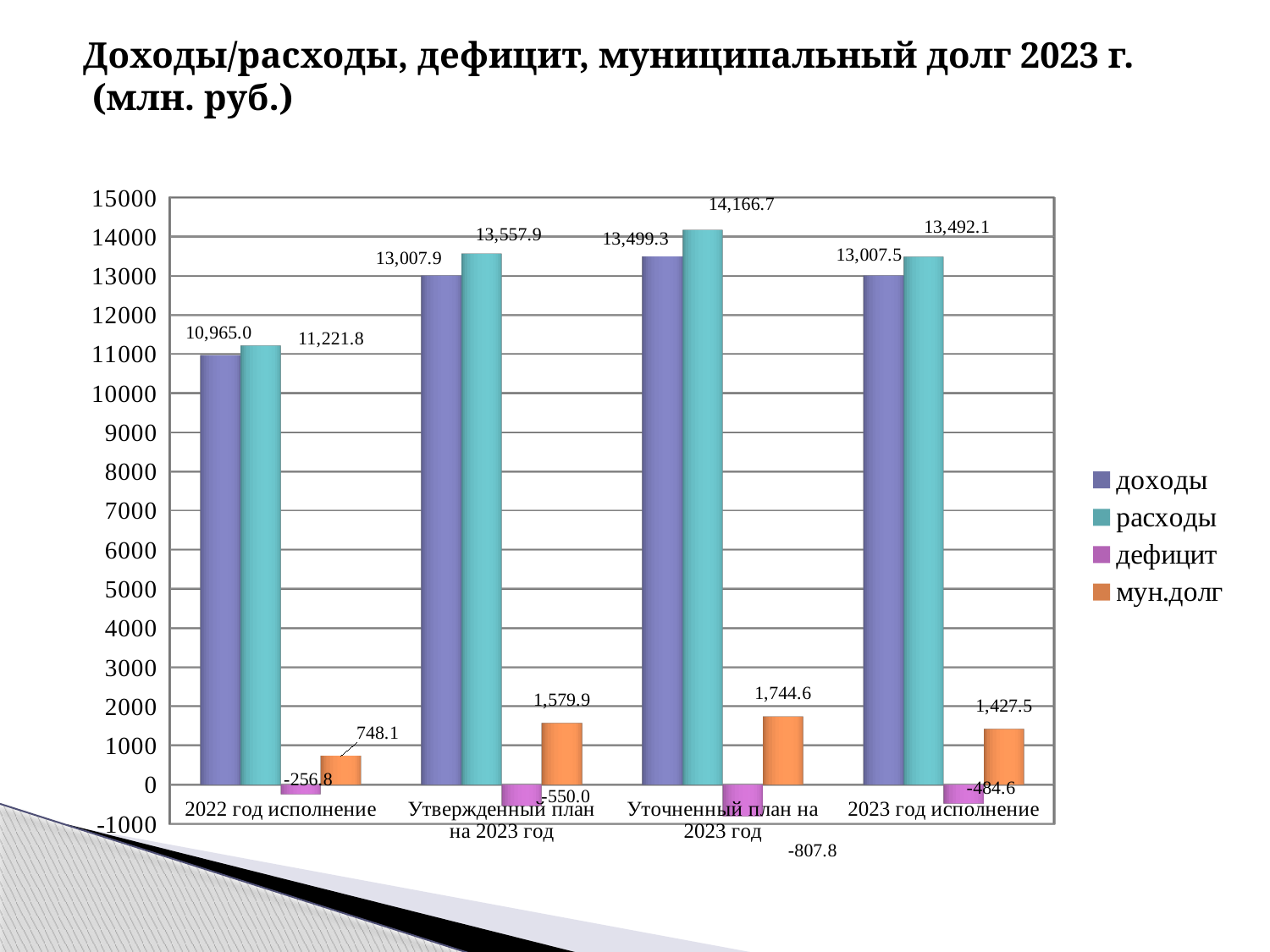
What is the value of расходы for Уточненный план на 2023 год? 14,166.7 How many categories are shown on the x axis? 4 What is the value of мун.долг for 2023 год исполнение? 1,427.5 Which category has the lowest value of мун.долг? 2022 год исполнение Which is larger: мун.долг for Утвержденный план на 2023 год or мун.долг for Уточненный план на 2023 год? Уточненный план на 2023 год What is the difference between расходы and доходы for 2023 год исполнение? 484.6 What type of chart is shown on the slide? bar chart What is the value of доходы for 2022 год исполнение? 10,965.0 Which category has the highest value of расходы? Уточненный план на 2023 год What is the value of дефицит for Утвержденный план на 2023 год? -550.0 How many series does the legend list? 4 Which series is shown in orange in the legend? мун.долг